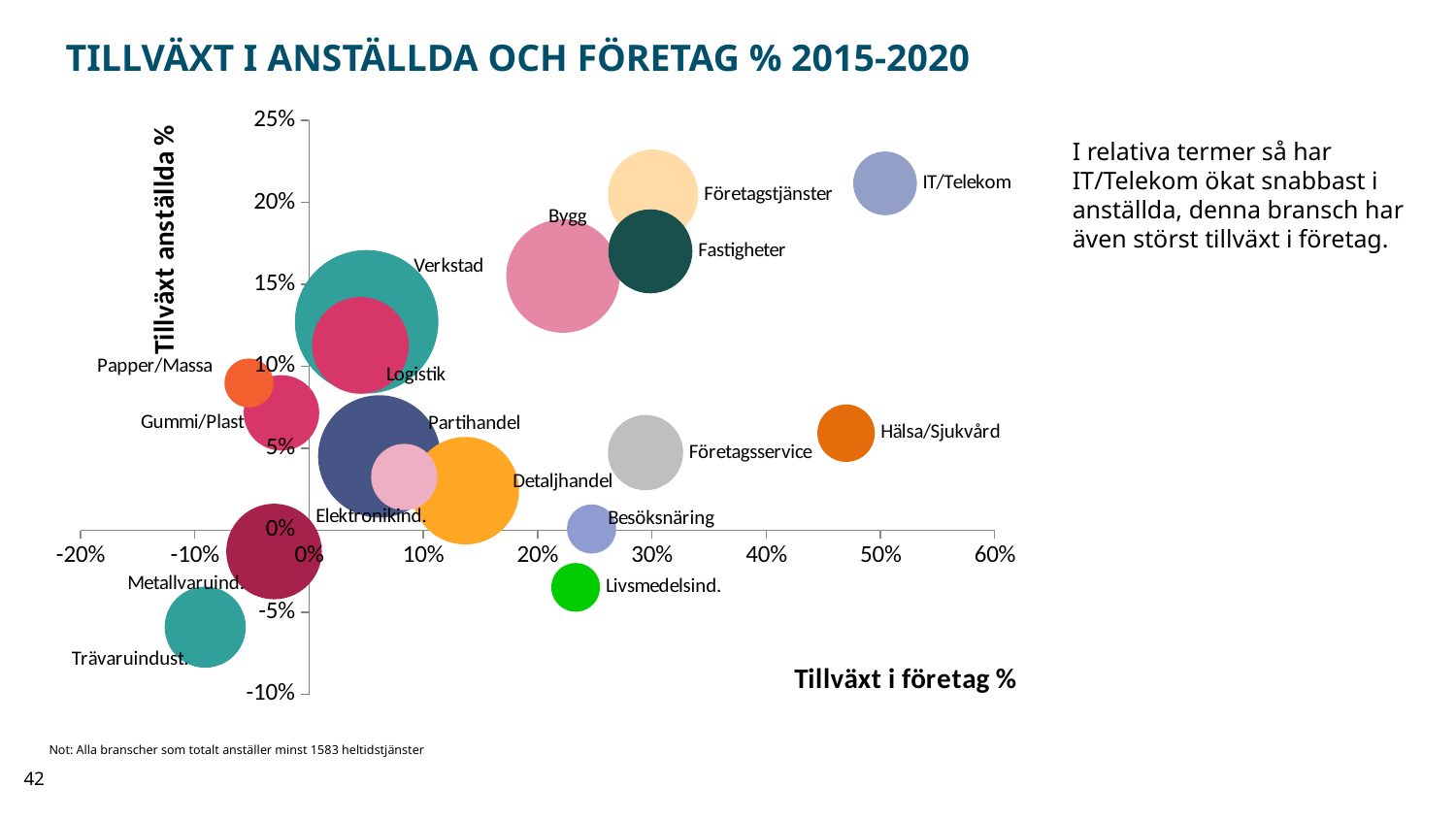
Is the growth in employees for Livsmedelsind. greater or less than 0%? less What is the label of the horizontal axis? Tillväxt i företag % Which industry has the highest growth in companies (furthest right on the x axis)? IT/Telekom What kind of chart is shown on the slide? Bubble chart Is the growth in employees for Bygg greater or less than 10%? greater Which industry has the lowest growth in companies (furthest left on the x axis)? Trävaruindust. What is the title of the chart? TILLVÄXT I ANSTÄLLDA OCH FÖRETAG % 2015-2020 How many industries (bubbles) are plotted in the chart? 17 Which industry has the lowest growth in employees (lowest on the y axis)? Trävaruindust. Which has the higher growth in companies, Hälsa/Sjukvård or Företagsservice? Hälsa/Sjukvård Which has the higher growth in employees, Bygg or Besöksnäring? Bygg Is the growth in companies for IT/Telekom greater or less than 40%? greater